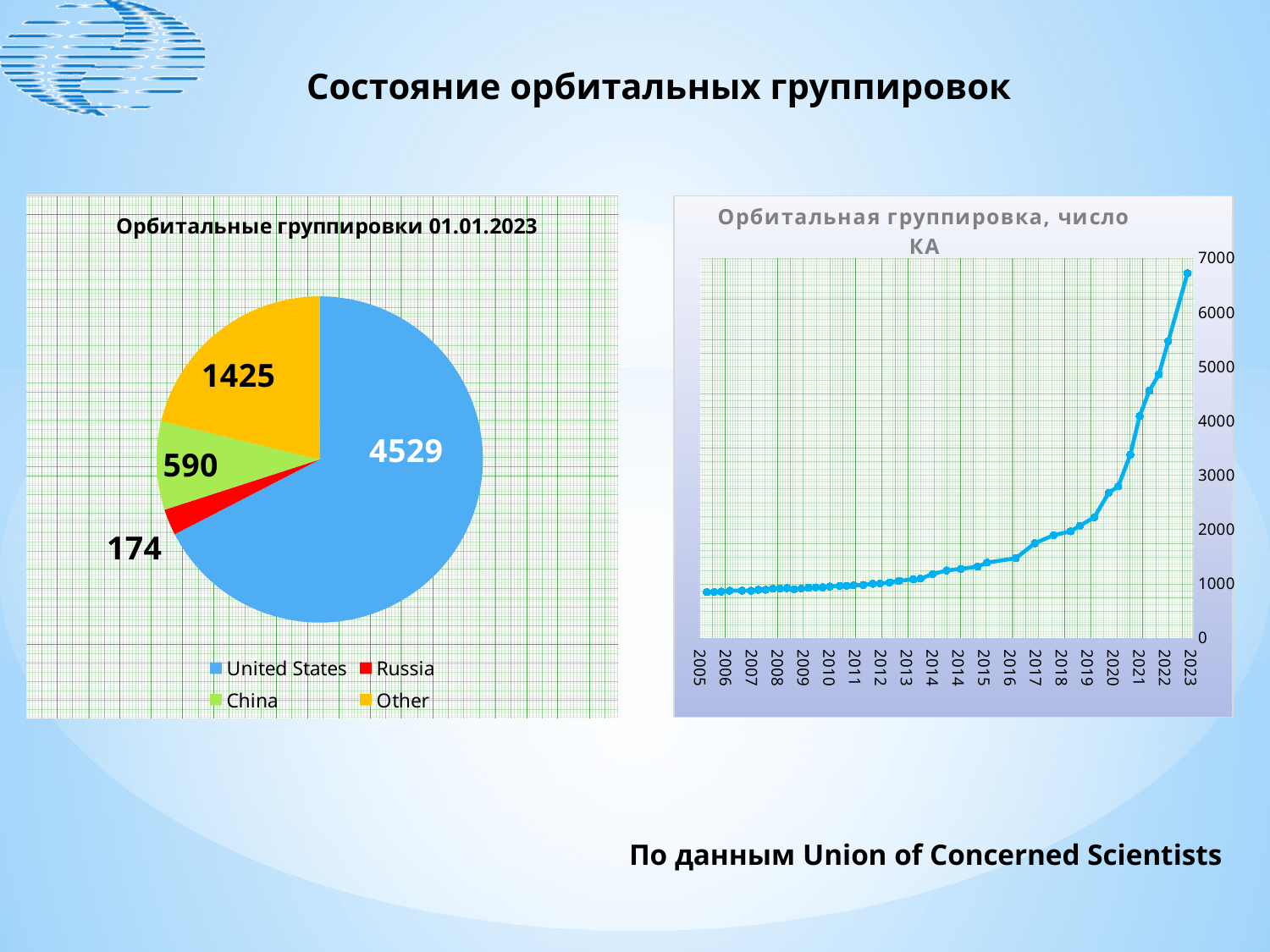
On the pie chart 'Орбитальные группировки 01.01.2023', which category has the smallest value? Russia On the pie chart 'Орбитальные группировки 01.01.2023', what is the value for United States? 4529 On the pie chart 'Орбитальные группировки 01.01.2023', what colour is the Other slice? Yellow/orange What kind of chart is the chart titled 'Орбитальная группировка, число КА'? Line chart On the pie chart 'Орбитальные группировки 01.01.2023', how many categories does the legend list? 4 On the line chart 'Орбитальная группировка, число КА', do the values rise or fall from 2005 to 2023? Rise On the pie chart 'Орбитальные группировки 01.01.2023', what is the value for China? 590 On the pie chart 'Орбитальные группировки 01.01.2023', which category has the largest value? United States On the line chart 'Орбитальная группировка, число КА', is the value for 2023 greater or less than 6000? greater On the pie chart 'Орбитальные группировки 01.01.2023', what is the difference between the values for Other and China? 835 On the pie chart 'Орбитальные группировки 01.01.2023', what is the value for Russia? 174 On the pie chart 'Орбитальные группировки 01.01.2023', which is larger, the value for China or the value for Russia? China